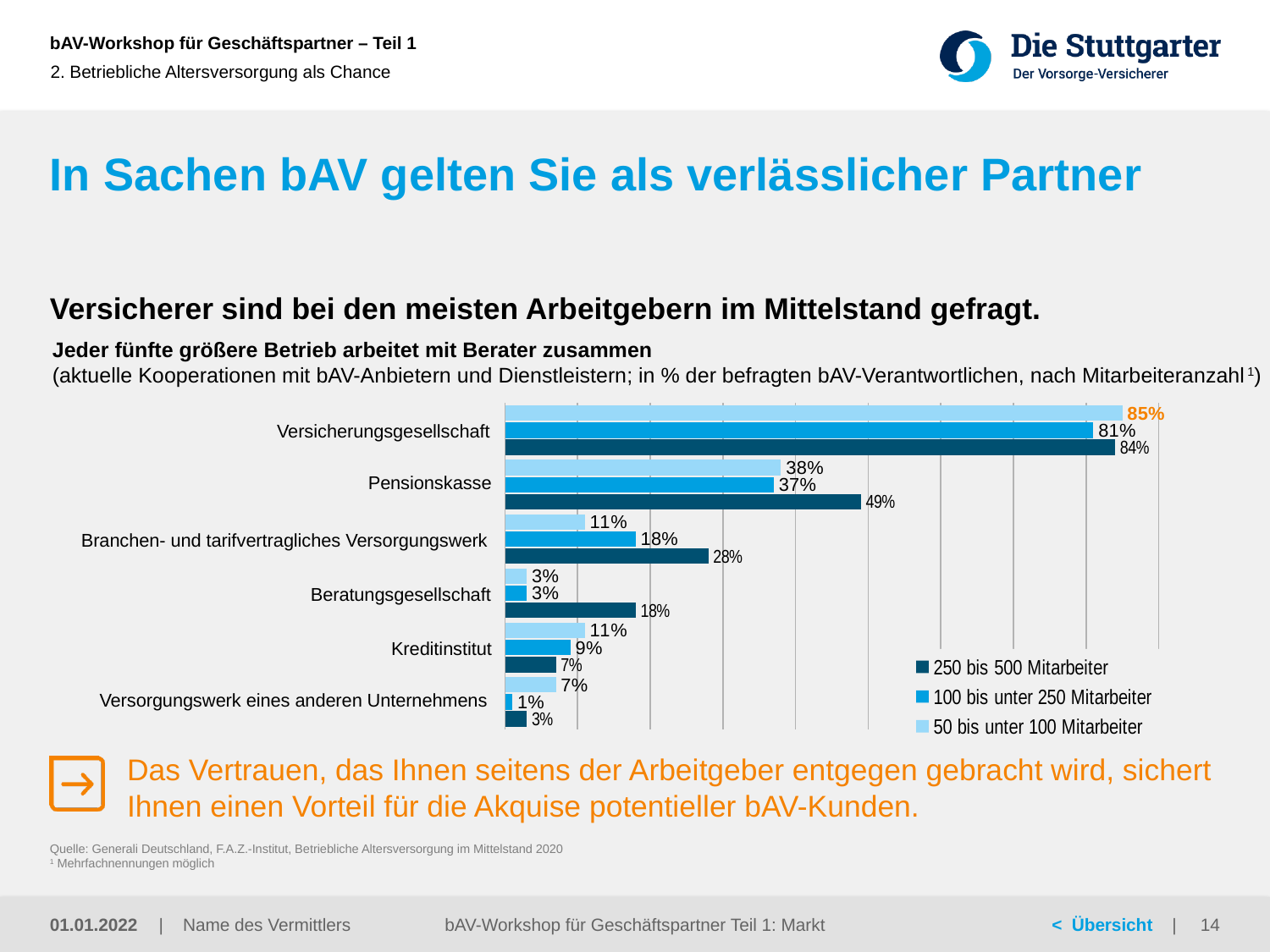
Which category has the lowest value in the '100 bis unter 250 Mitarbeiter' series? Versorgungswerk eines anderen Unternehmens For Pensionskasse, what is the difference between the '250 bis 500 Mitarbeiter' value and the '50 bis unter 100 Mitarbeiter' value? 11 percentage points What is the value for Versicherungsgesellschaft in the '50 bis unter 100 Mitarbeiter' series? 85% What is the value for Kreditinstitut in the '100 bis unter 250 Mitarbeiter' series? 9% How many categories are shown on the chart? 6 For Branchen- und tarifvertragliches Versorgungswerk, which series has the larger value: '250 bis 500 Mitarbeiter' or '100 bis unter 250 Mitarbeiter'? 250 bis 500 Mitarbeiter What kind of chart is shown on the slide? Bar chart How many series does the legend list? 3 What is the value for Pensionskasse in the '250 bis 500 Mitarbeiter' series? 49% For Versicherungsgesellschaft, what is the difference between the '50 bis unter 100 Mitarbeiter' value and the '100 bis unter 250 Mitarbeiter' value? 4 percentage points Which category has the highest value in the '250 bis 500 Mitarbeiter' series? Versicherungsgesellschaft What is the value for Beratungsgesellschaft in the '250 bis 500 Mitarbeiter' series? 18%